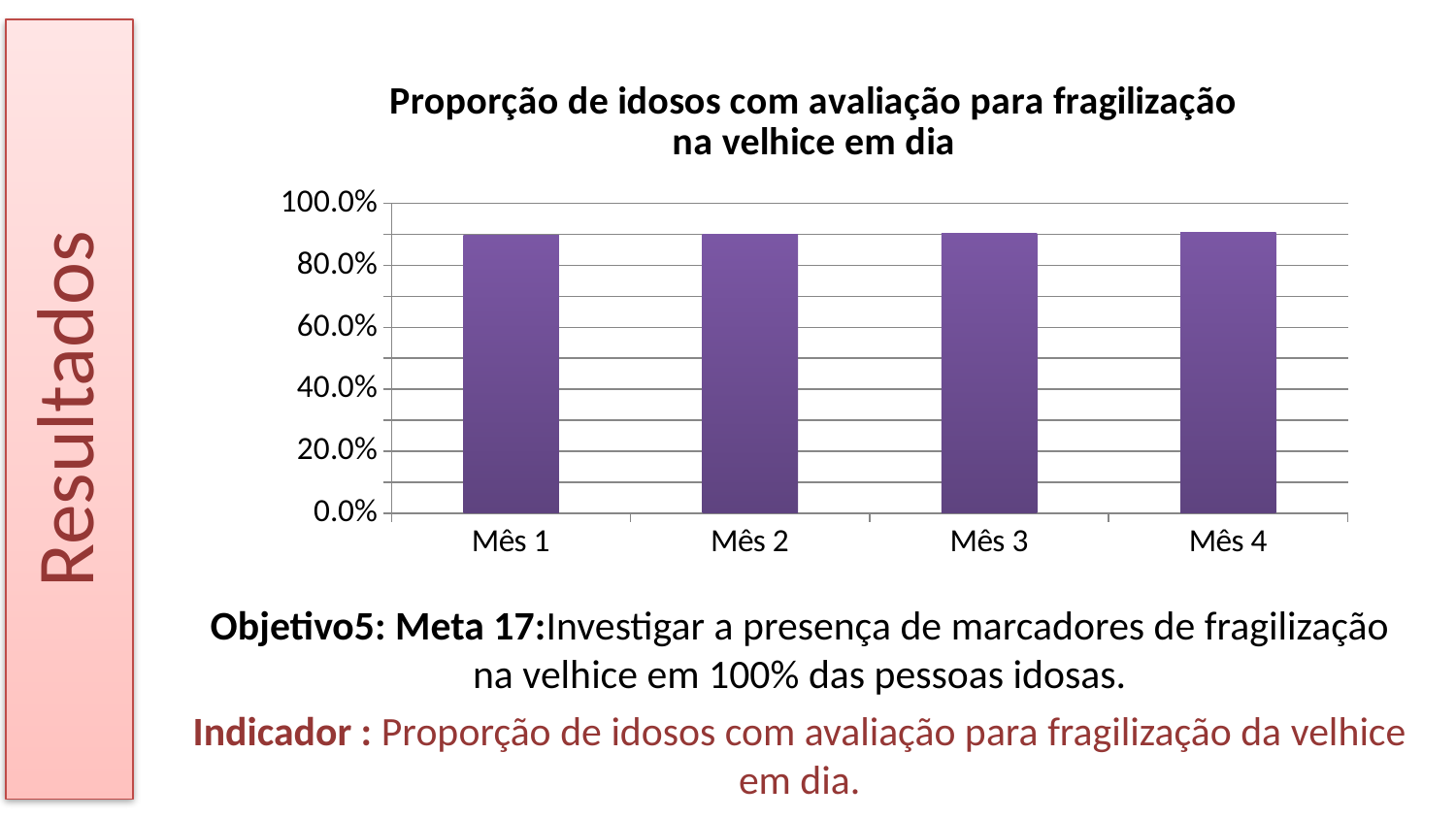
Is the value for Mês 2 greater or less than 100.0%? less What is the label of the first category on the x axis? Mês 1 How many categories are shown on the x axis of the chart? 4 What is the highest tick value shown on the y axis? 100.0% Do the values rise, fall, or stay roughly flat from Mês 1 to Mês 4? roughly flat What is the title of the chart? Proporção de idosos com avaliação para fragilização na velhice em dia Is the value for Mês 1 greater or less than 80.0%? greater Is the value for Mês 3 greater or less than 60.0%? greater What kind of chart is shown on the slide? bar chart